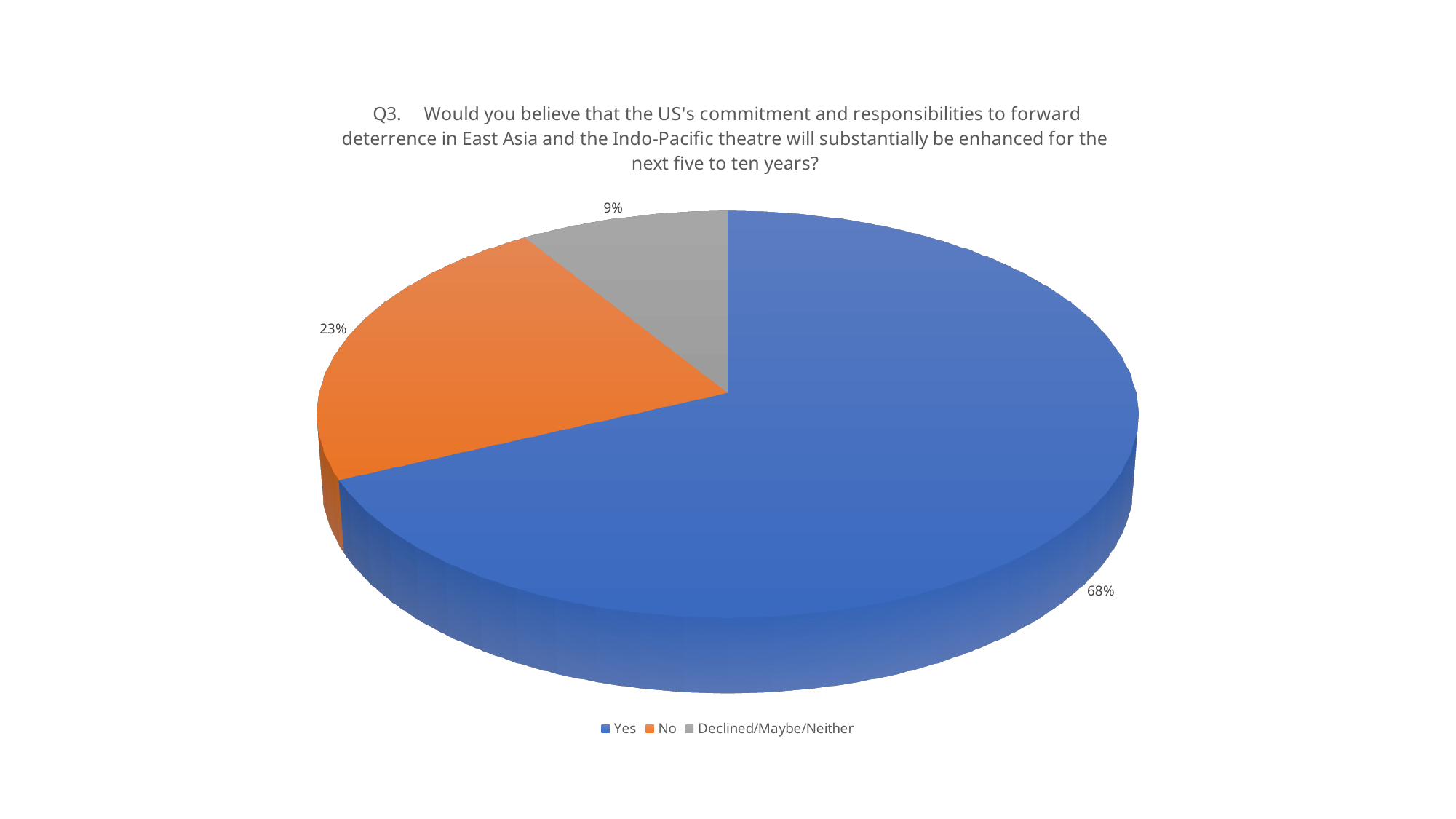
What percentage of respondents answered Declined/Maybe/Neither? 9% What is the difference in percentage points between the Yes and No shares? 45 Which is larger, the share for No or the share for Declined/Maybe/Neither? No How many slices does the pie chart have? 3 How many entries does the legend list? 3 What colour is the slice representing No? Orange Which response has the smallest share of the pie? Declined/Maybe/Neither What percentage of respondents answered No? 23% What kind of chart is shown on the slide? Pie chart Which response has the largest share of the pie? Yes What is the difference in percentage points between the No and Declined/Maybe/Neither shares? 14 What percentage of respondents answered Yes? 68%